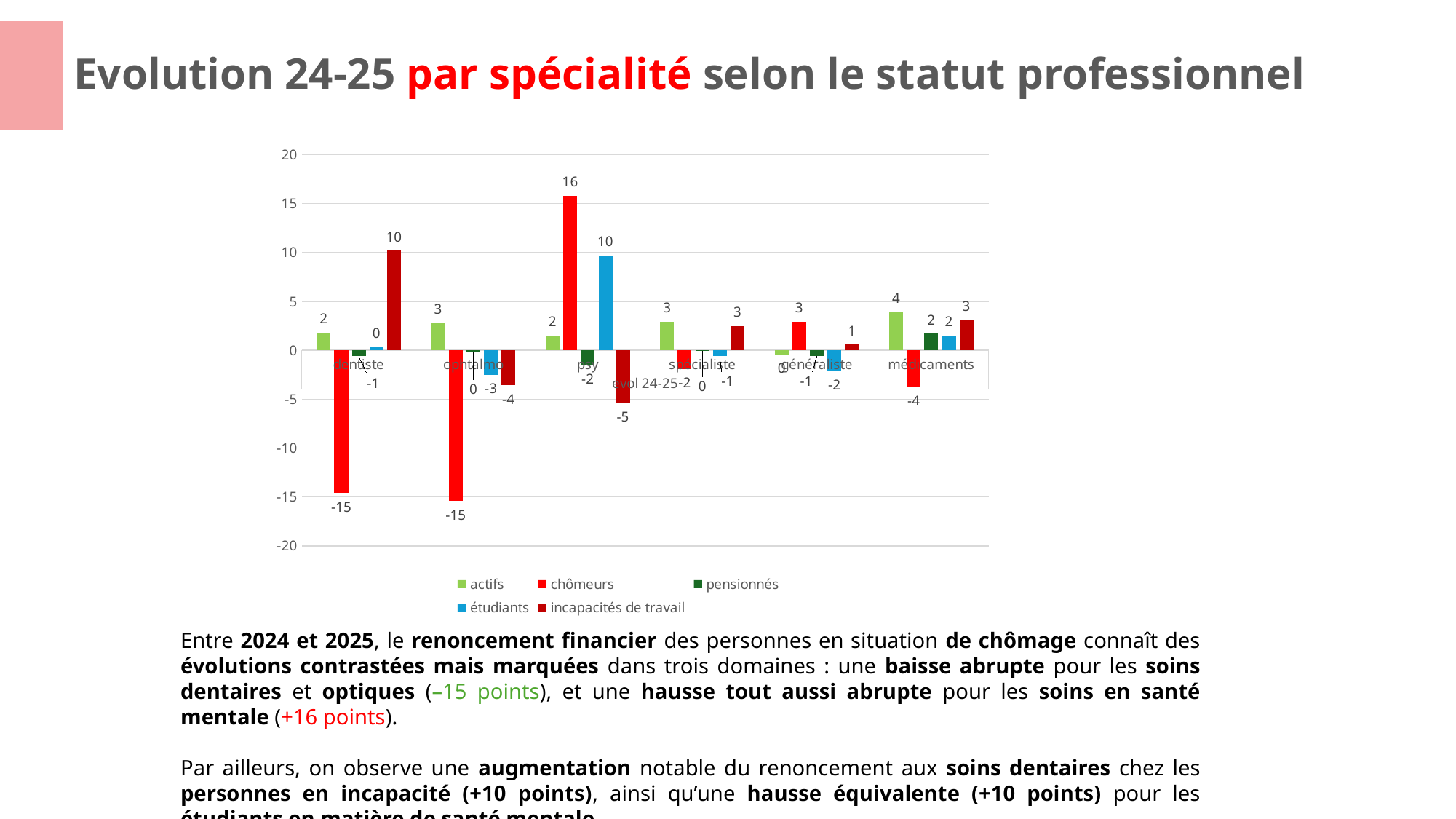
Which series has the lowest value in the ophtalmo category? chômeurs How many series does the legend list? 5 What is the difference between the chômeurs value for psy and the étudiants value for psy? 6 What is the value for chômeurs in the psy category? 16 What is the value for étudiants in the psy category? 10 How many categories are shown on the x axis? 6 Which is larger: the actifs value for médicaments or the actifs value for ophtalmo? médicaments What is the value for chômeurs in the dentiste category? -15 What is the value for actifs in the médicaments category? 4 What kind of chart is shown on the slide? bar chart Which series has the highest value in the psy category? chômeurs What is the value for incapacités de travail in the dentiste category? 10